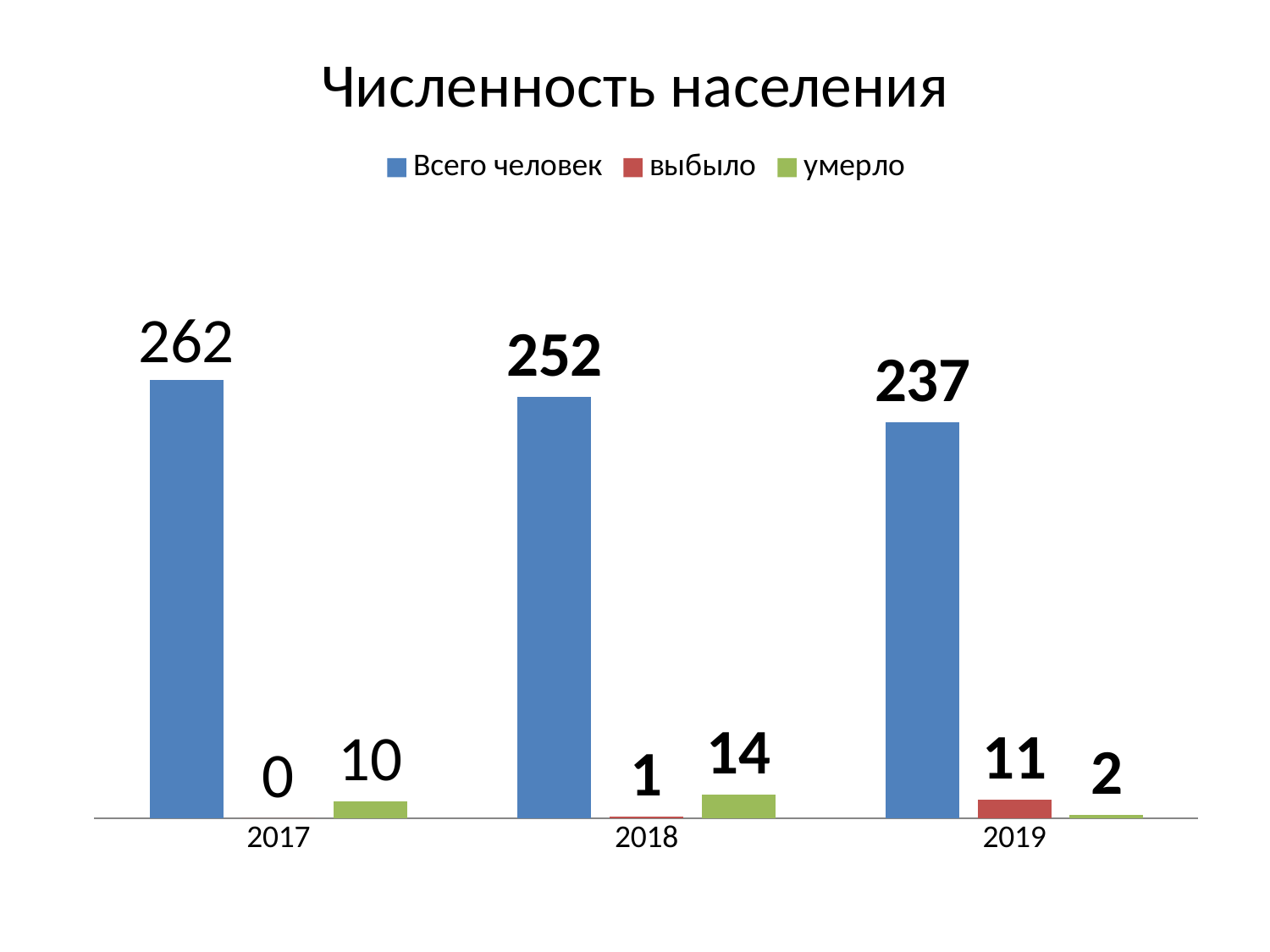
Which year has the highest value for 'Всего человек'? 2017 How many series does the legend list? 3 Which is larger: 'выбыло' in 2018 or 'выбыло' in 2019? 2019 What is the value of 'Всего человек' for 2017? 262 What is the value of 'выбыло' for 2019? 11 How many years are shown on the x axis? 3 What is the value of 'умерло' for 2018? 14 What is the title of the chart? Численность населения What is the difference between 'Всего человек' in 2017 and 2019? 25 Which year has the lowest value for 'умерло'? 2019 Does the value of 'Всего человек' rise or fall from 2017 to 2019? Fall What kind of chart is shown on the slide? Bar chart